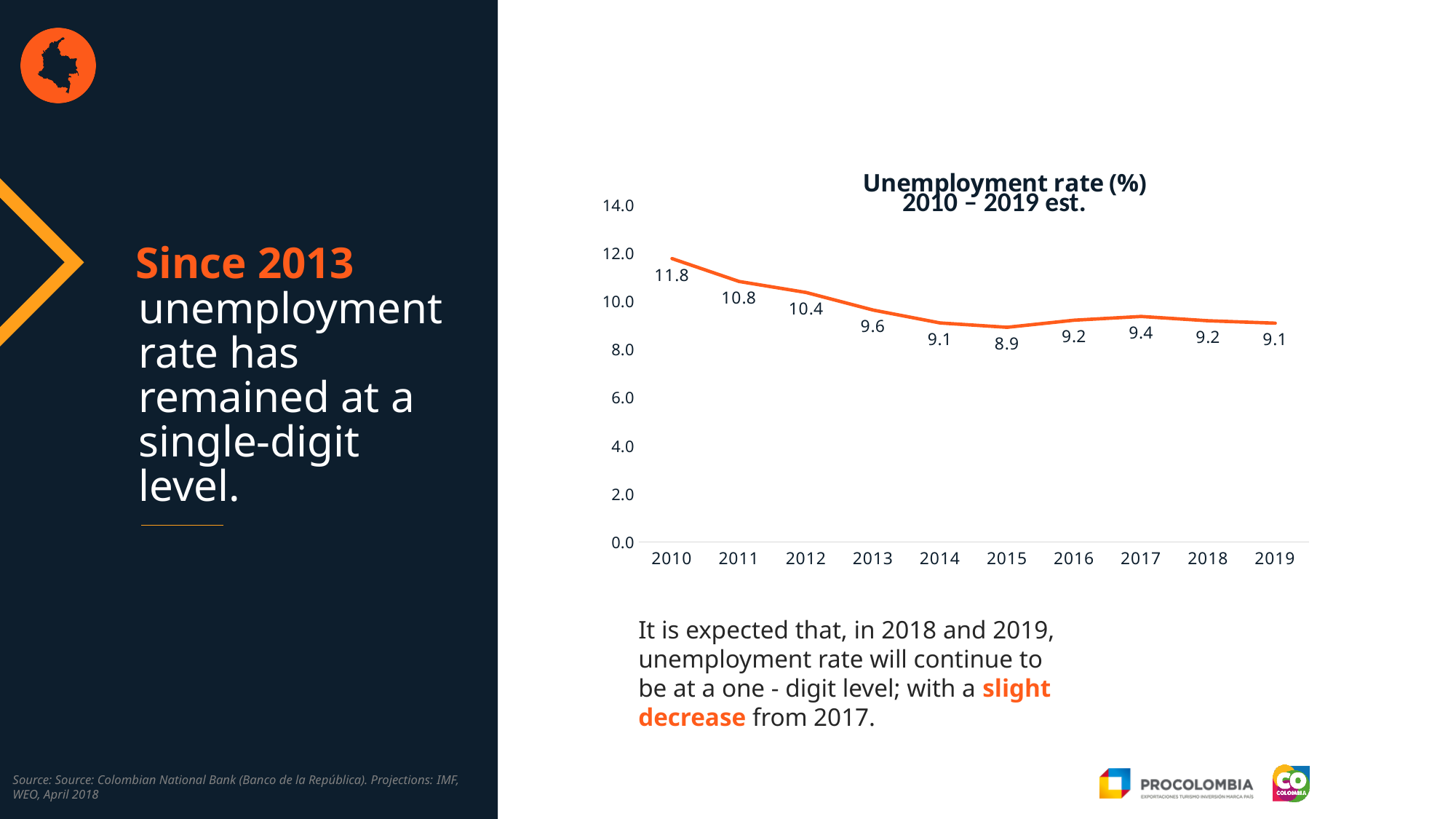
What is the unemployment rate for 2019? 9.1 Which year has a higher unemployment rate, 2012 or 2017? 2012 Which year has the highest unemployment rate? 2010 Does the unemployment rate rise or fall from 2010 to 2015? fall What is the unemployment rate for 2010? 11.8 What is the title of the chart? Unemployment rate (%) 2010 – 2019 est. How many years are plotted on the chart? 10 Is the unemployment rate for 2013 greater or less than 10.0? less Which year has the lowest unemployment rate? 2015 What is the unemployment rate for 2015? 8.9 What kind of chart is shown on the slide? line chart What is the difference between the unemployment rate in 2010 and in 2019? 2.7